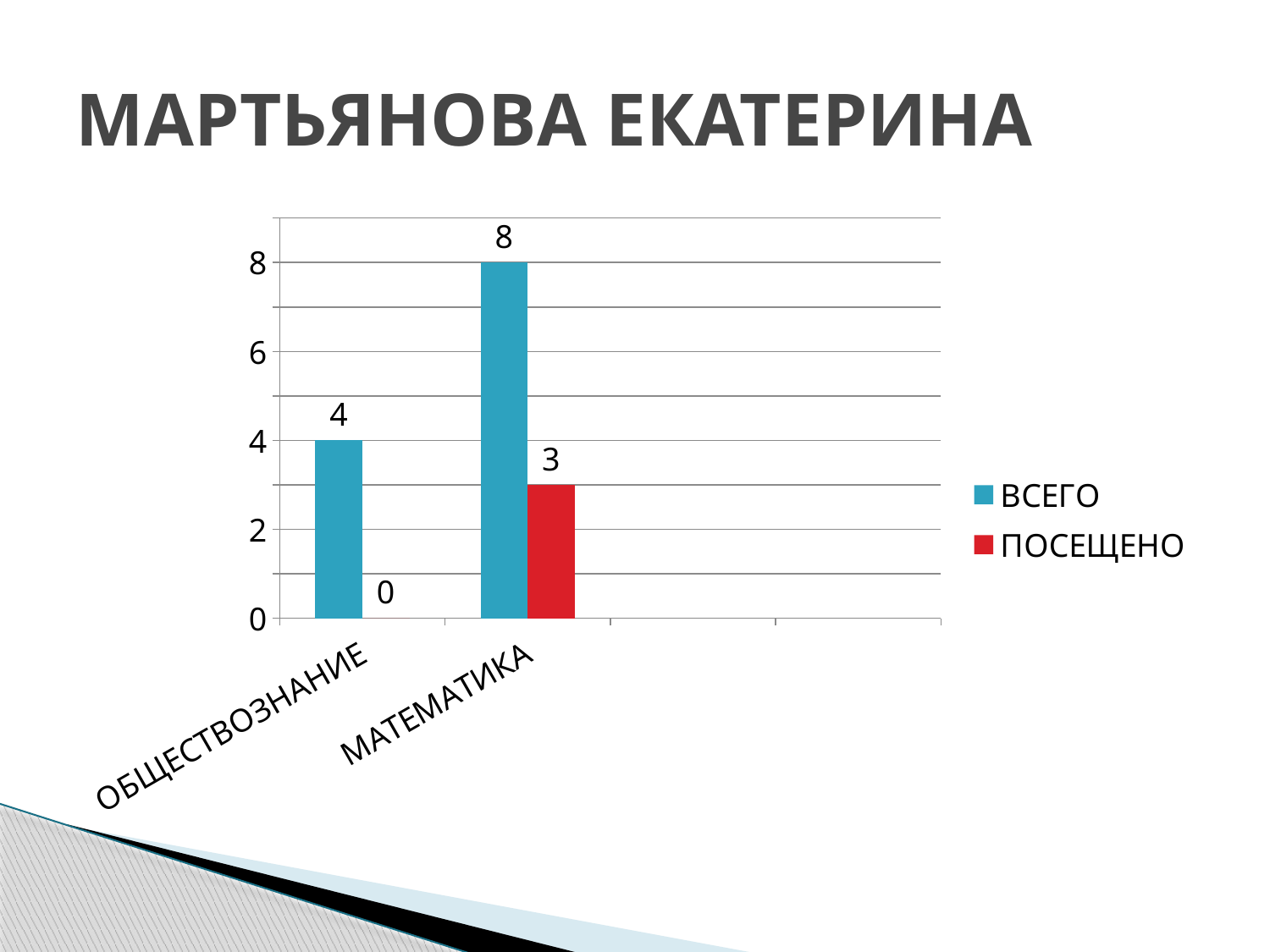
What is the ВСЕГО value for ОБЩЕСТВОЗНАНИЕ? 4 How many series does the legend list? 2 What is the difference between ВСЕГО and ПОСЕЩЕНО for МАТЕМАТИКА? 5 Which is larger: the ВСЕГО value for ОБЩЕСТВОЗНАНИЕ or the ПОСЕЩЕНО value for МАТЕМАТИКА? ВСЕГО for ОБЩЕСТВОЗНАНИЕ What is the difference between the ВСЕГО values for МАТЕМАТИКА and ОБЩЕСТВОЗНАНИЕ? 4 What is the ВСЕГО value for МАТЕМАТИКА? 8 What is the ПОСЕЩЕНО value for ОБЩЕСТВОЗНАНИЕ? 0 Which category has the highest ВСЕГО value? МАТЕМАТИКА What kind of chart is shown on the slide? Bar chart Which category has the lowest ПОСЕЩЕНО value? ОБЩЕСТВОЗНАНИЕ What is the ПОСЕЩЕНО value for МАТЕМАТИКА? 3 How many categories are shown on the x axis? 2